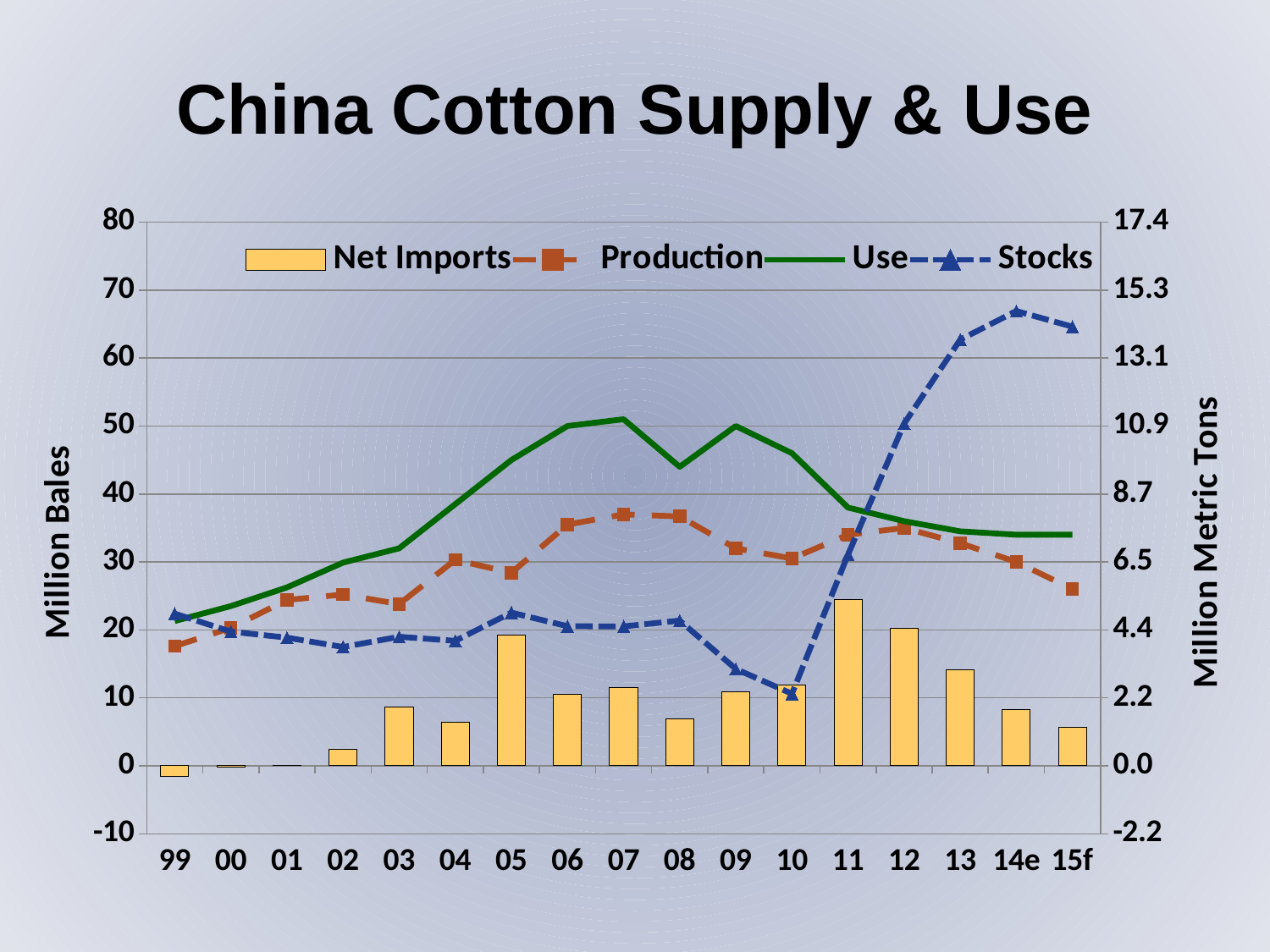
In which year is the Net Imports bar the highest? 11 How many series does the legend list? 4 Is the Stocks value for 10 greater or less than 20 million bales? less What is the label of the right-hand vertical axis? Million Metric Tons What kind of chart is shown on the slide? A combination bar and line chart In which year is the Net Imports bar the lowest? 99 Is the Net Imports value for 11 greater or less than 20 million bales? greater In 07, which is larger, Use or Production? Use How many years (categories) are shown along the x axis? 17 Does the Stocks line rise or fall from 10 to 14e? Rise Is the Stocks value for 14e greater or less than 60 million bales? greater In which year does the Stocks line reach its highest point? 14e